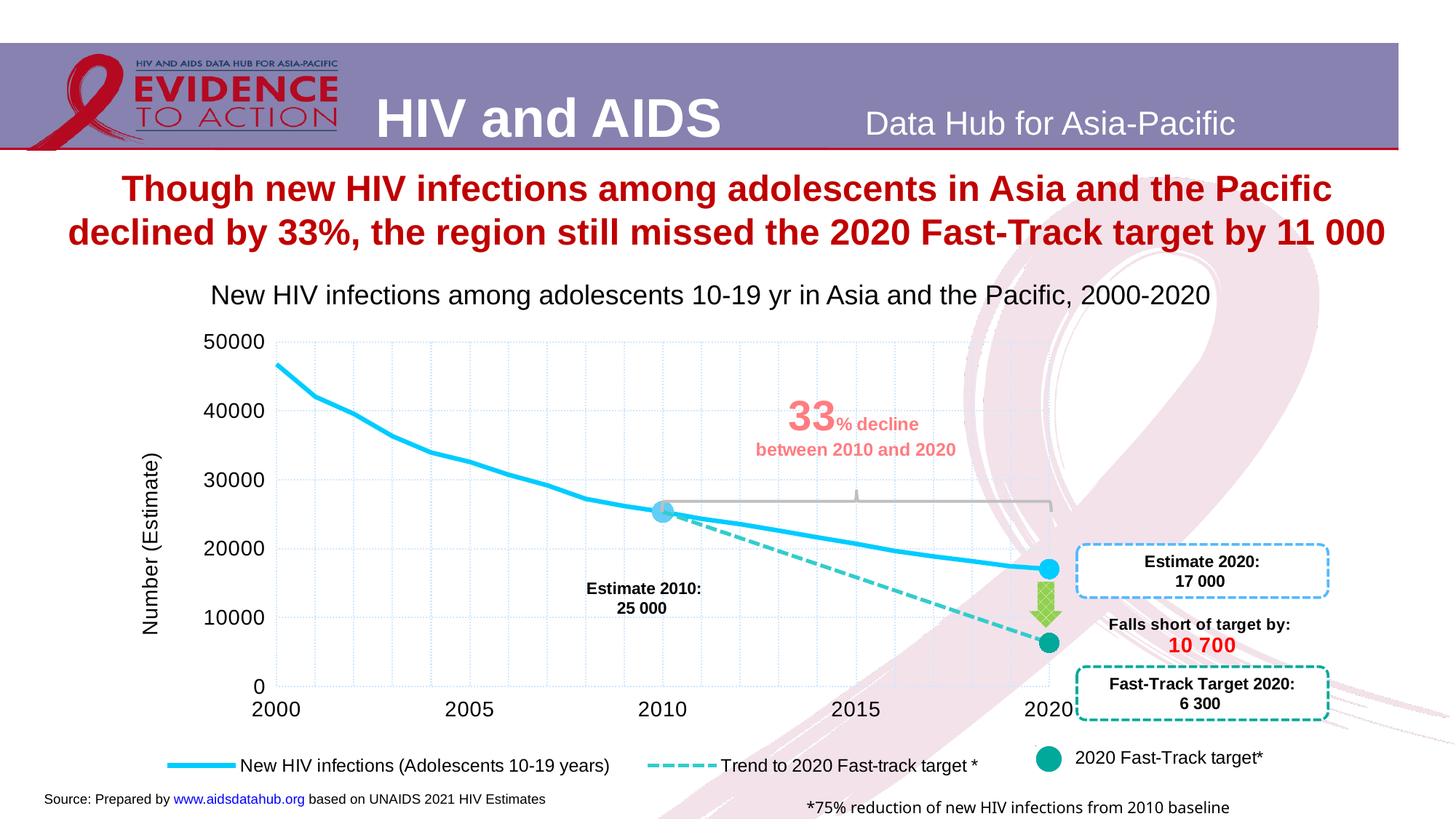
How many entries does the legend list? 3 Which is larger, the 2020 estimate or the 2020 Fast-Track Target? The 2020 estimate Do new HIV infections among adolescents rise or fall from 2000 to 2020? Fall Is the value for 2015 greater or less than 30000? less What type of chart is shown on the slide? Line chart What is the estimated number of new HIV infections among adolescents in 2020? 17 000 What is the Fast-Track Target for 2020? 6 300 What is the difference between the 2010 estimate and the 2020 estimate? 8 000 What is the estimated number of new HIV infections among adolescents in 2010? 25 000 What is the title of the chart? New HIV infections among adolescents 10-19 yr in Asia and the Pacific, 2000-2020 Is the value for 2000 greater or less than 40000? greater By how much does the 2020 estimate fall short of the Fast-Track Target? 10 700